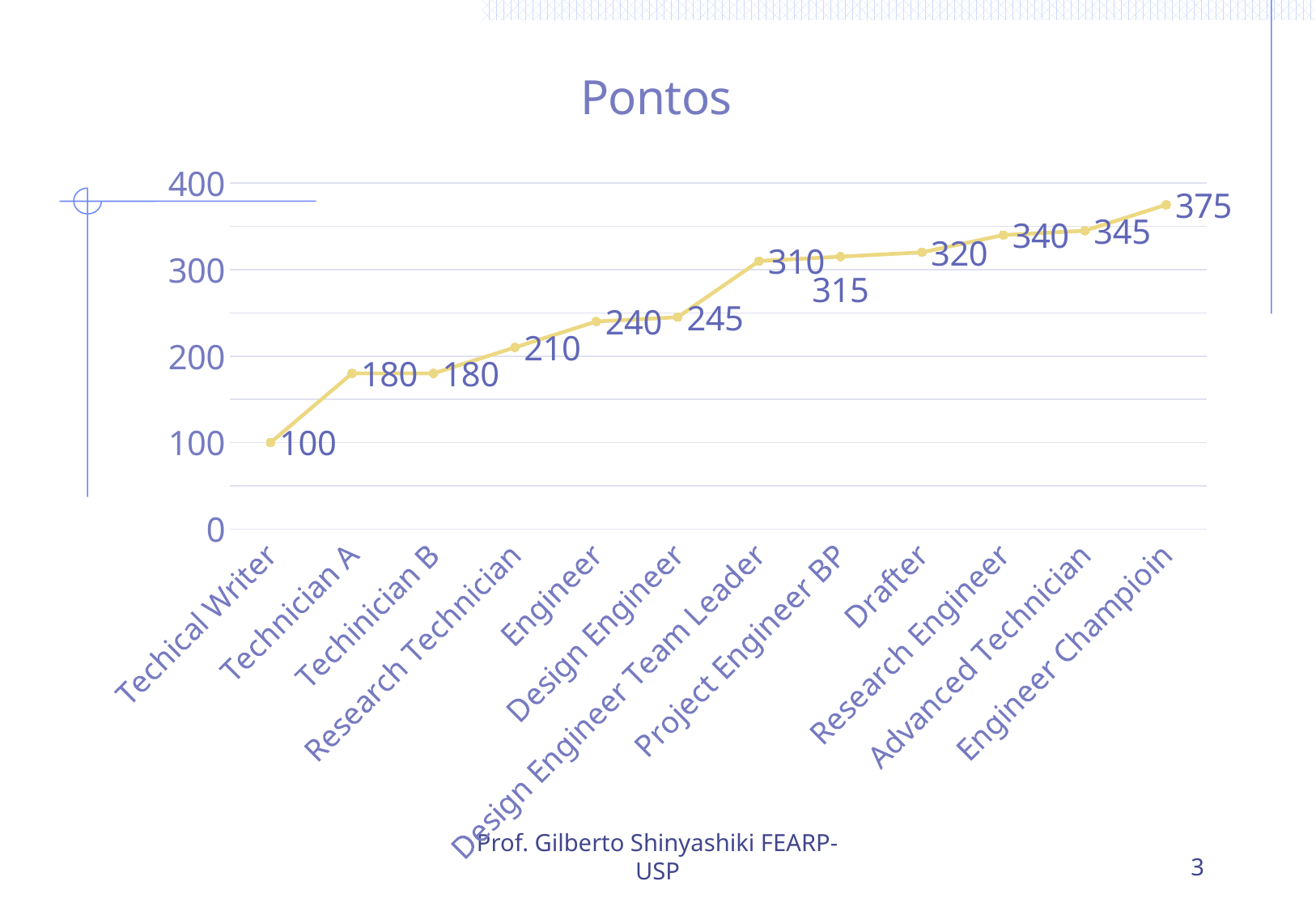
How many categories are shown on the x axis? 12 What is the value for Research Technician? 210 What is the title of the chart? Pontos What is the value for Techical Writer? 100 What is the value for Engineer Champioin? 375 What is the value for Design Engineer Team Leader? 310 What is the difference between the values for Drafter and Engineer? 80 Which category has the highest value? Engineer Champioin What kind of chart is this? Line chart Which is larger, the value for Project Engineer BP or the value for Design Engineer? Project Engineer BP Do the values rise or fall from left to right along the x axis? Rise Which category has the lowest value? Techical Writer